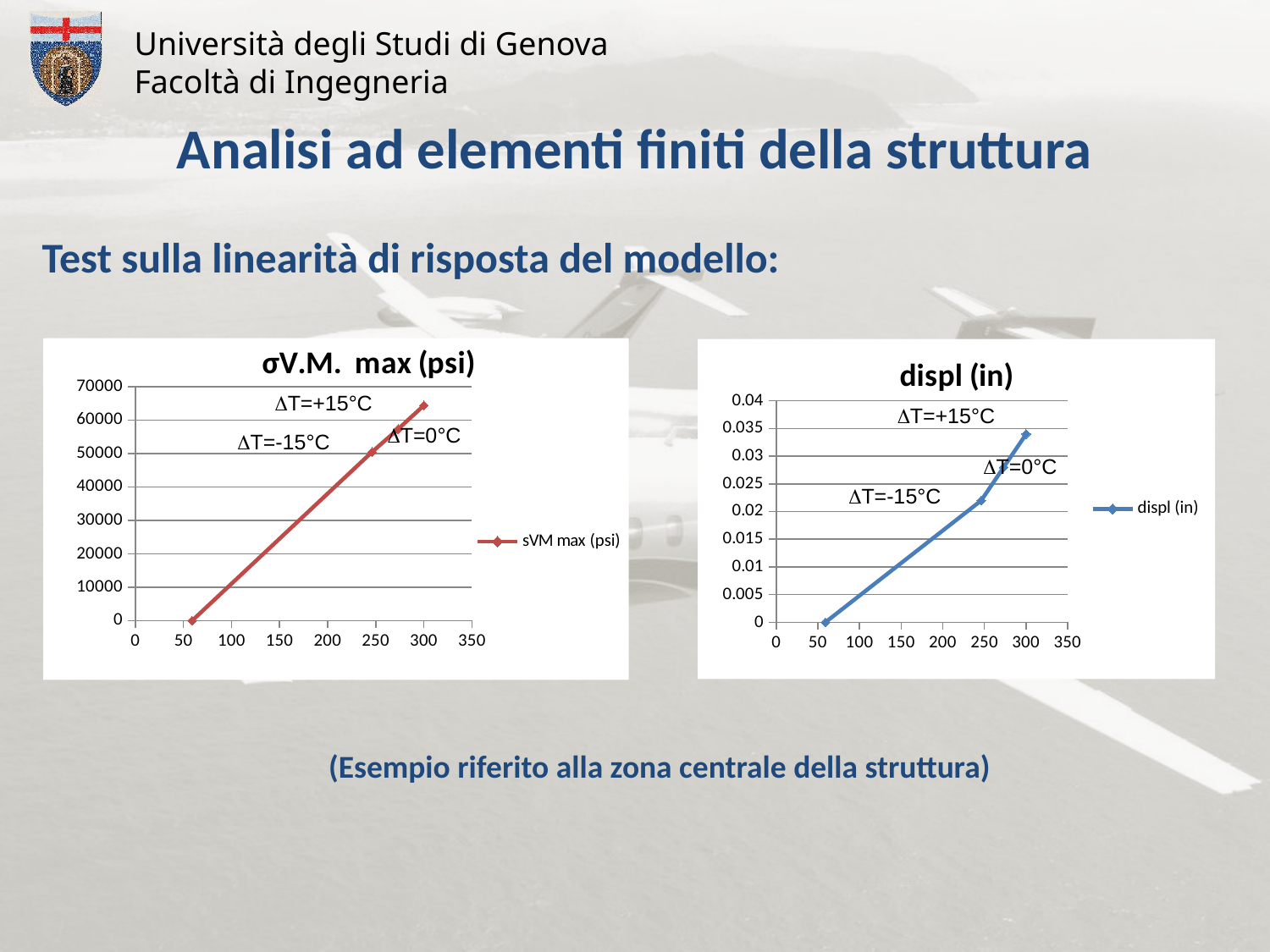
In the left chart "σV.M. max (psi)", do the values rise or fall as x increases? rise What is the legend entry of the left chart "σV.M. max (psi)"? sVM max (psi) What kind of chart is the left chart titled "σV.M. max (psi)"? line chart In the right chart "displ (in)", do the values rise or fall as x increases? rise In the right chart "displ (in)", how many data points are plotted? 4 In the left chart "σV.M. max (psi)", is the value at x = 300 greater or less than 60000? greater How many series does the legend of the left chart "σV.M. max (psi)" list? 1 In the right chart "displ (in)", is the value at x = 300 greater or less than 0.03? greater What is the legend entry of the right chart "displ (in)"? displ (in) What kind of chart is the right chart titled "displ (in)"? line chart In the left chart "σV.M. max (psi)", how many data points are plotted? 4 In the right chart "displ (in)", which is larger: the value at x = 250 or the value at x = 300? x = 300